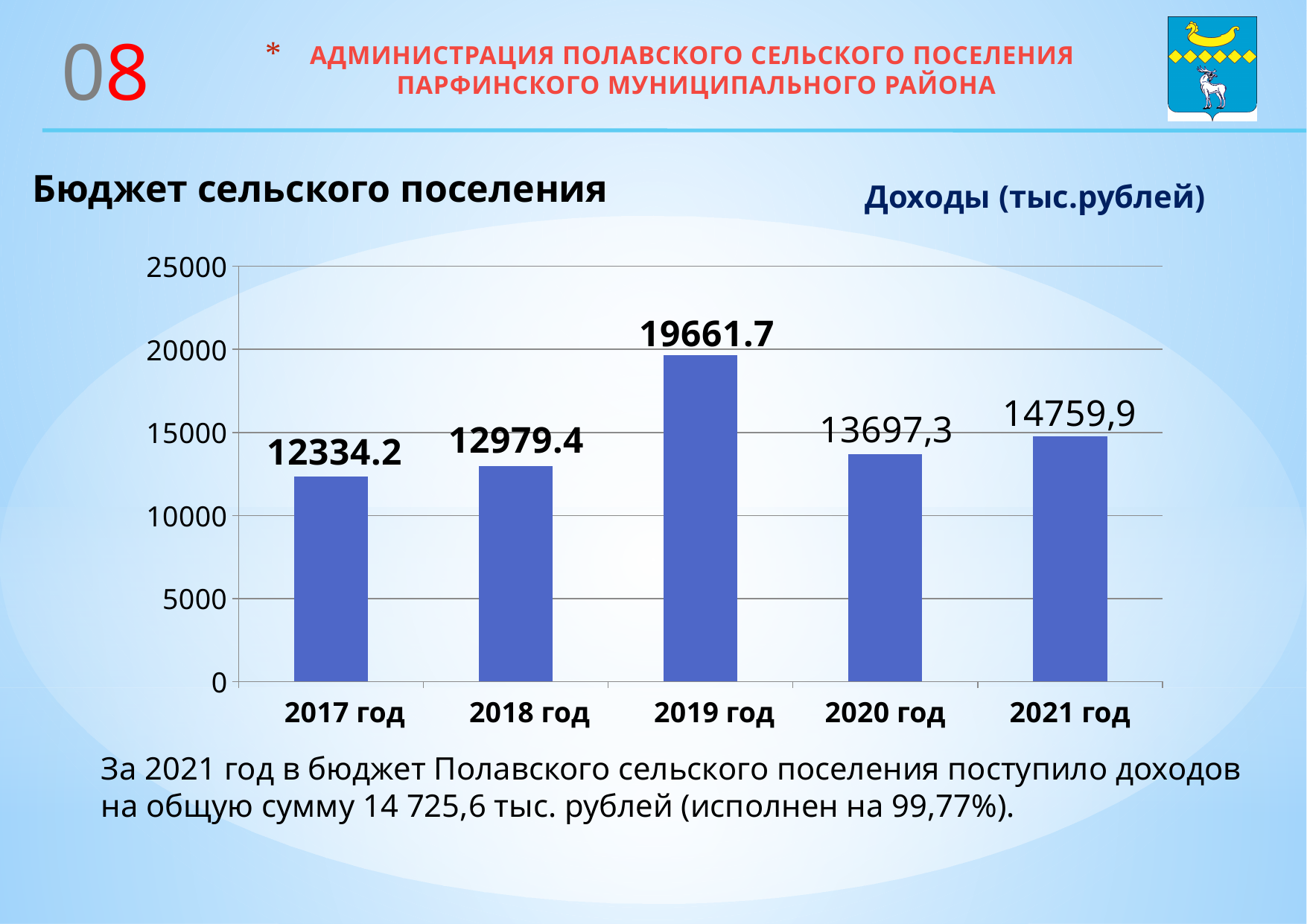
Which year has the lowest value? 2017 год What is the title of the chart? Доходы (тыс.рублей) How many years are shown on the x axis? 5 What kind of chart is shown on the slide? bar chart Which is larger, the value for 2018 год or the value for 2020 год? 2020 год What is the value for 2021 год? 14759,9 What is the difference between the values for 2019 год and 2017 год? 7327.5 Which year has the highest value? 2019 год What is the value for 2017 год? 12334.2 What is the value for 2020 год? 13697,3 What is the difference between the values for 2021 год and 2020 год? 1062,6 What is the value for 2019 год? 19661.7